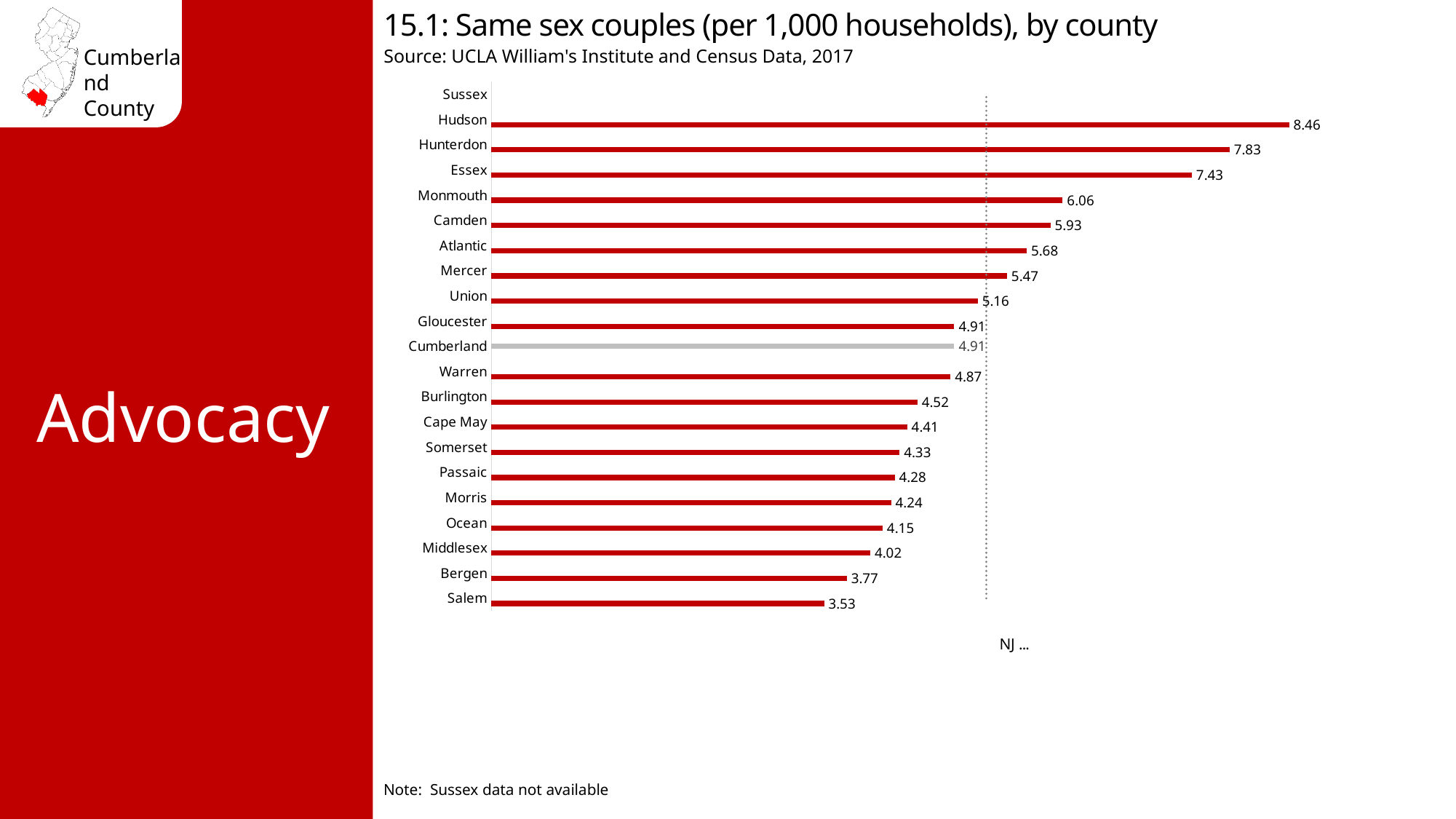
What is the value for Salem County? 3.53 Which county's bar is shown in grey instead of red? Cumberland Which county with a plotted bar has the lowest value? Salem Which county has the highest number of same sex couples per 1,000 households? Hudson What is the value for Cumberland County? 4.91 What is the difference between the values for Hunterdon and Essex? 0.40 What is the difference between the values for Hudson and Salem? 4.93 Which has a larger value, Camden or Atlantic? Camden What kind of chart is shown on the slide? Bar chart How many counties are listed on the vertical axis of the chart? 21 Do the bar values increase or decrease going from Hudson at the top down to Salem at the bottom? Decrease What is the value for Hudson County? 8.46